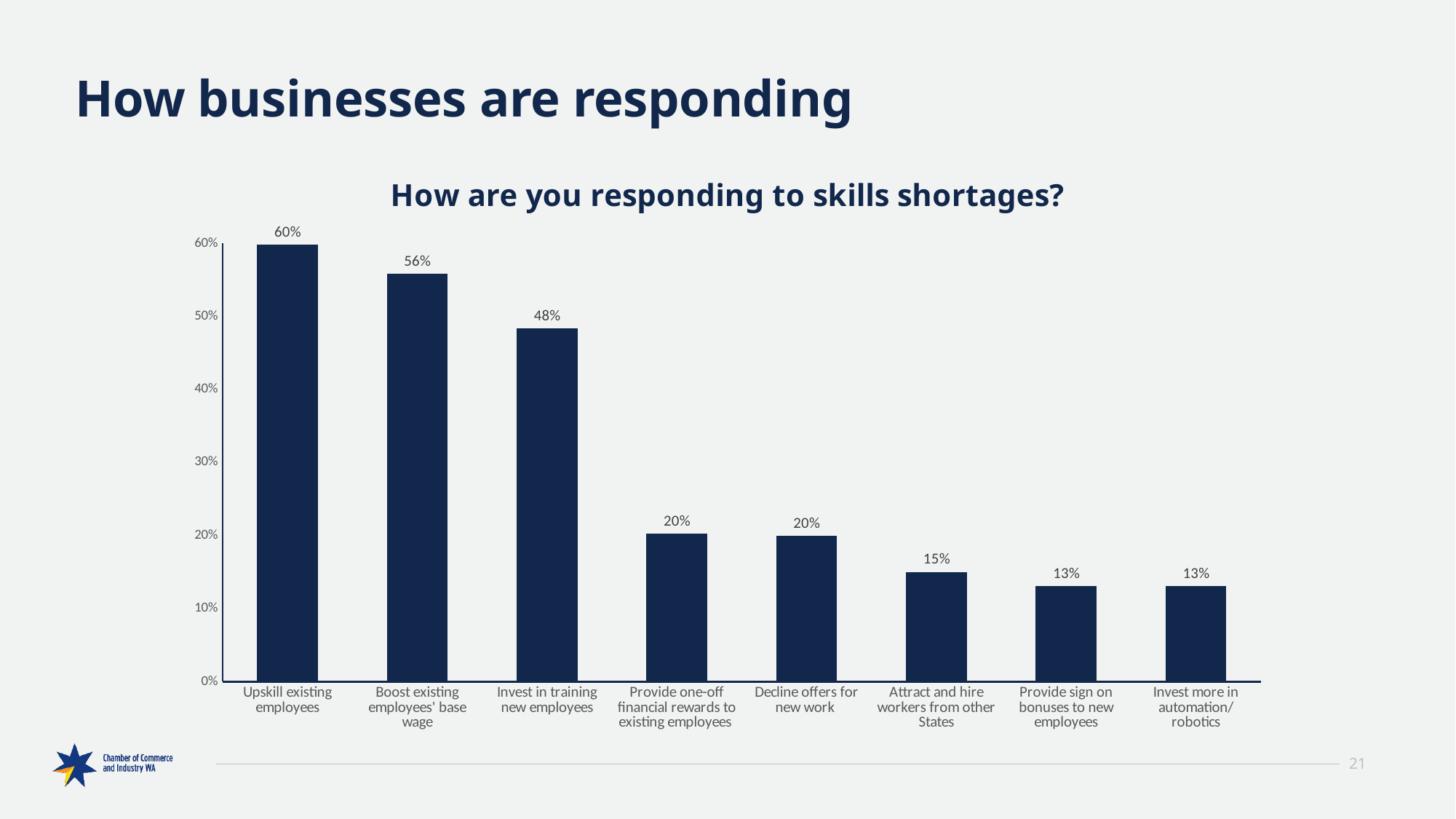
Which response has the highest percentage? Upskill existing employees What kind of chart is shown on the slide? Bar chart How many response categories are shown in the chart? 8 What percentage of businesses said they would attract and hire workers from other States? 15% What is the difference between 'Invest in training new employees' and 'Decline offers for new work'? 28% What is the difference between 'Upskill existing employees' and 'Boost existing employees' base wage'? 4% What is the title of the chart? How are you responding to skills shortages? Which is larger: 'Boost existing employees' base wage' or 'Provide one-off financial rewards to existing employees'? Boost existing employees' base wage Do the values rise or fall from left to right across the categories? Fall Is the value for 'Provide sign on bonuses to new employees' greater or less than 20%? less What is the value for 'Invest in training new employees'? 48% What percentage of businesses said they would upskill existing employees? 60%